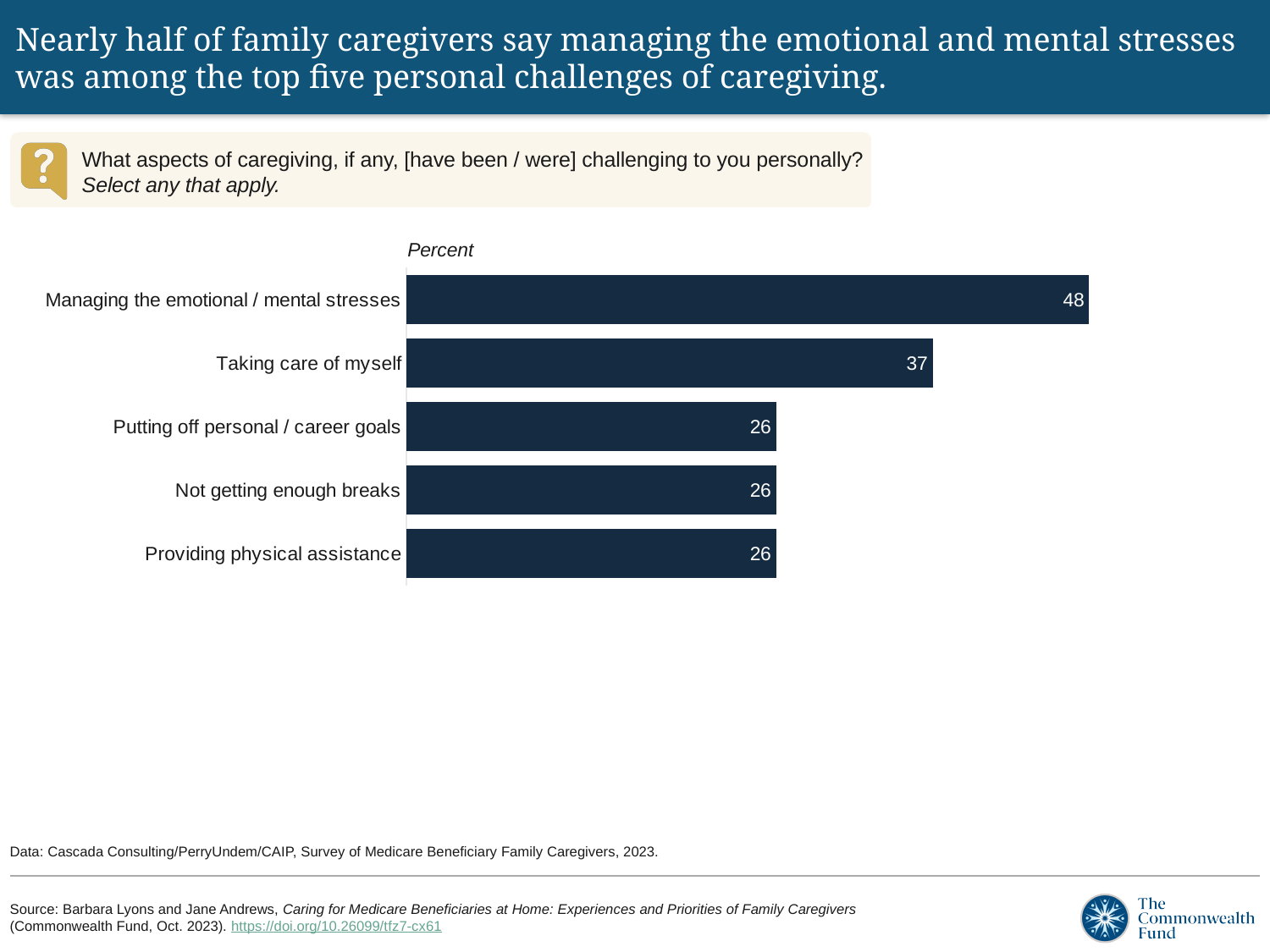
What is the value shown for 'Taking care of myself'? 37 How many categories are shown in the chart? 5 Which category has the highest value in the chart? Managing the emotional / mental stresses What is the difference between the values for 'Managing the emotional / mental stresses' and 'Taking care of myself'? 11 Which is larger: the value for 'Taking care of myself' or the value for 'Putting off personal / career goals'? Taking care of myself What is the difference between the values for 'Taking care of myself' and 'Providing physical assistance'? 11 Do the values increase or decrease going from the top bar to the bottom bar? Decrease What unit label is shown above the chart? Percent What is the value shown for 'Not getting enough breaks'? 26 What percent of family caregivers said managing the emotional / mental stresses was a personal challenge? 48 What kind of chart is shown on the slide? Bar chart How many categories share the value 26? 3